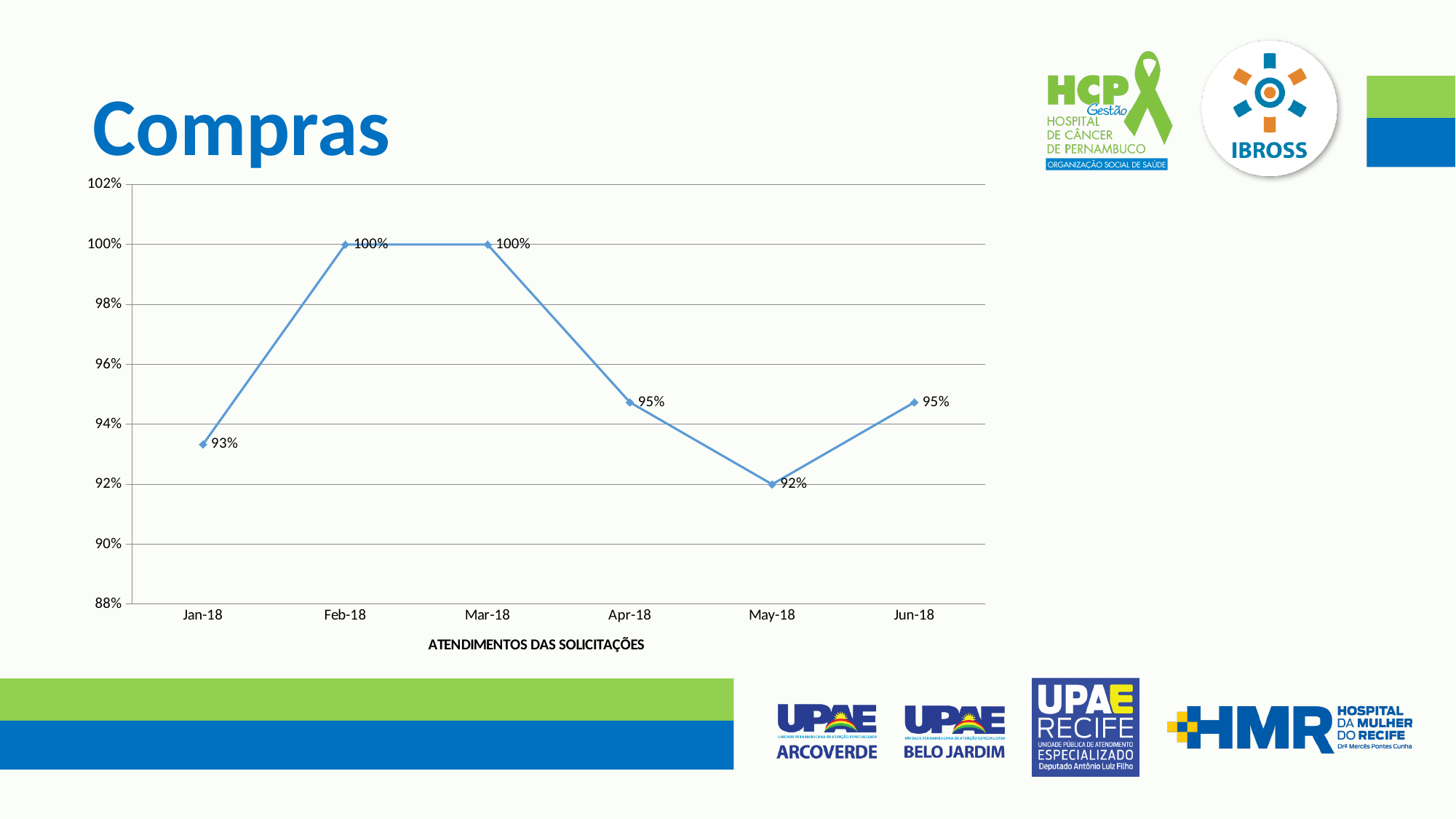
What is the value for Apr-18? 95% What is the value for Feb-18? 100% Does the value rise or fall from Apr-18 to May-18? fall What is the value for Jan-18? 93% What is the label shown below the x axis of the chart? ATENDIMENTOS DAS SOLICITAÇÕES What type of chart is shown on the slide? line chart What is the value for May-18? 92% Which month has the lowest value? May-18 What is the difference between the values for Jan-18 and May-18? 1% How many months are plotted on the x axis? 6 What is the difference between the values for Mar-18 and Apr-18? 5% Which is larger, the value for Jan-18 or the value for Jun-18? Jun-18